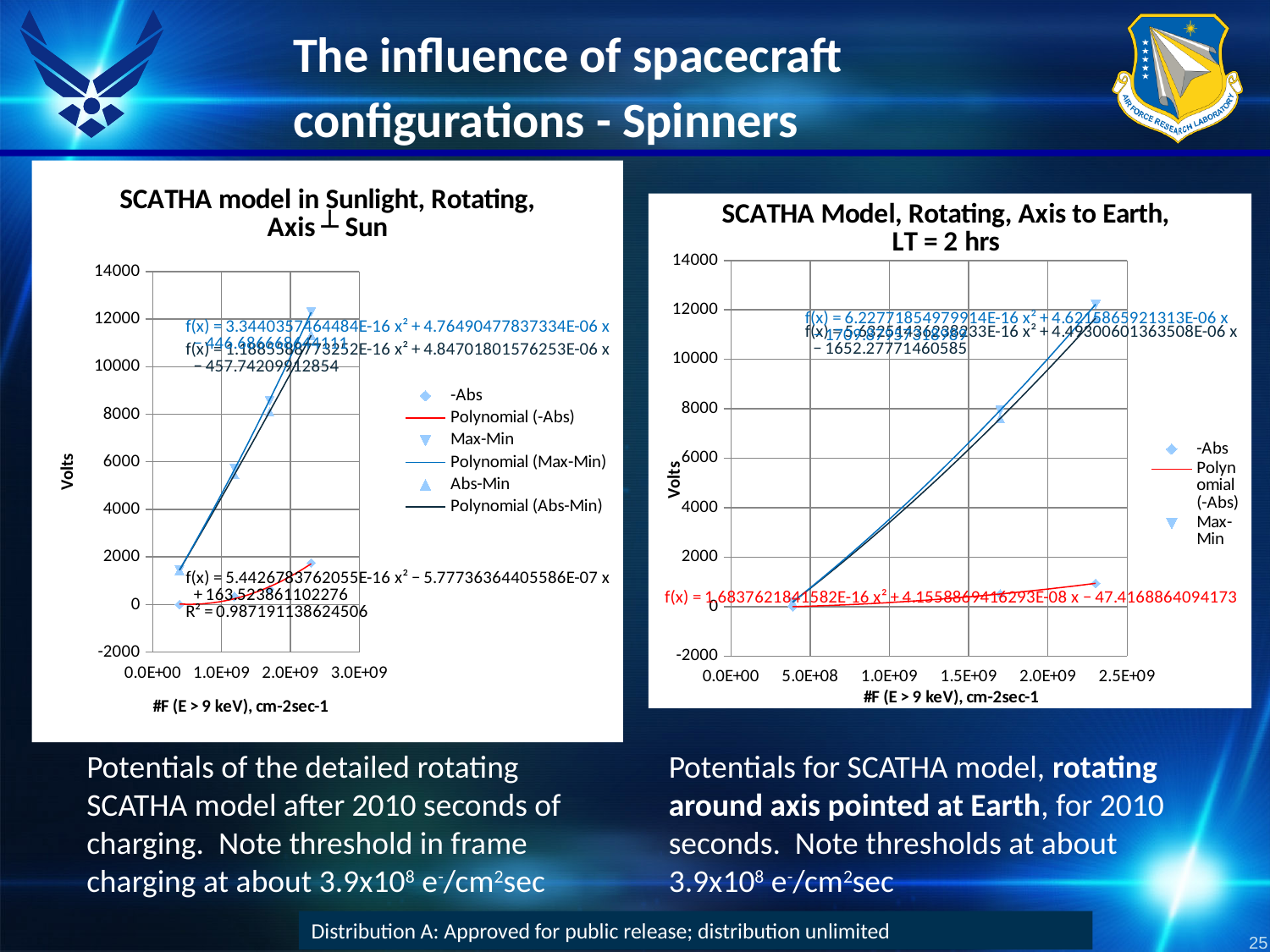
How many charts are shown on the slide? 2 In the 'SCATHA Model, Rotating, Axis to Earth, LT = 2 hrs' chart, is the highest Max-Min point greater or less than 10000 volts? greater What is the x-axis title of the 'SCATHA Model, Rotating, Axis to Earth, LT = 2 hrs' chart? #F (E > 9 keV), cm-2sec-1 How many series does the legend of the 'SCATHA model in Sunlight, Rotating, Axis ⊥ Sun' chart list? 6 How many series does the legend of the 'SCATHA Model, Rotating, Axis to Earth, LT = 2 hrs' chart list? 3 What is the y-axis title of the 'SCATHA model in Sunlight, Rotating, Axis ⊥ Sun' chart? Volts In the 'SCATHA model in Sunlight, Rotating, Axis ⊥ Sun' chart, is the highest -Abs point greater or less than 4000 volts? less In the 'SCATHA Model, Rotating, Axis to Earth, LT = 2 hrs' chart, do the Max-Min values rise or fall as the flux on the x axis increases? rise In the 'SCATHA model in Sunlight, Rotating, Axis ⊥ Sun' chart, at the highest flux value, which series has the larger value: Max-Min or -Abs? Max-Min In the 'SCATHA model in Sunlight, Rotating, Axis ⊥ Sun' chart, is the highest Max-Min point greater or less than 10000 volts? greater What kind of chart is the 'SCATHA Model, Rotating, Axis to Earth, LT = 2 hrs' chart? scatter chart